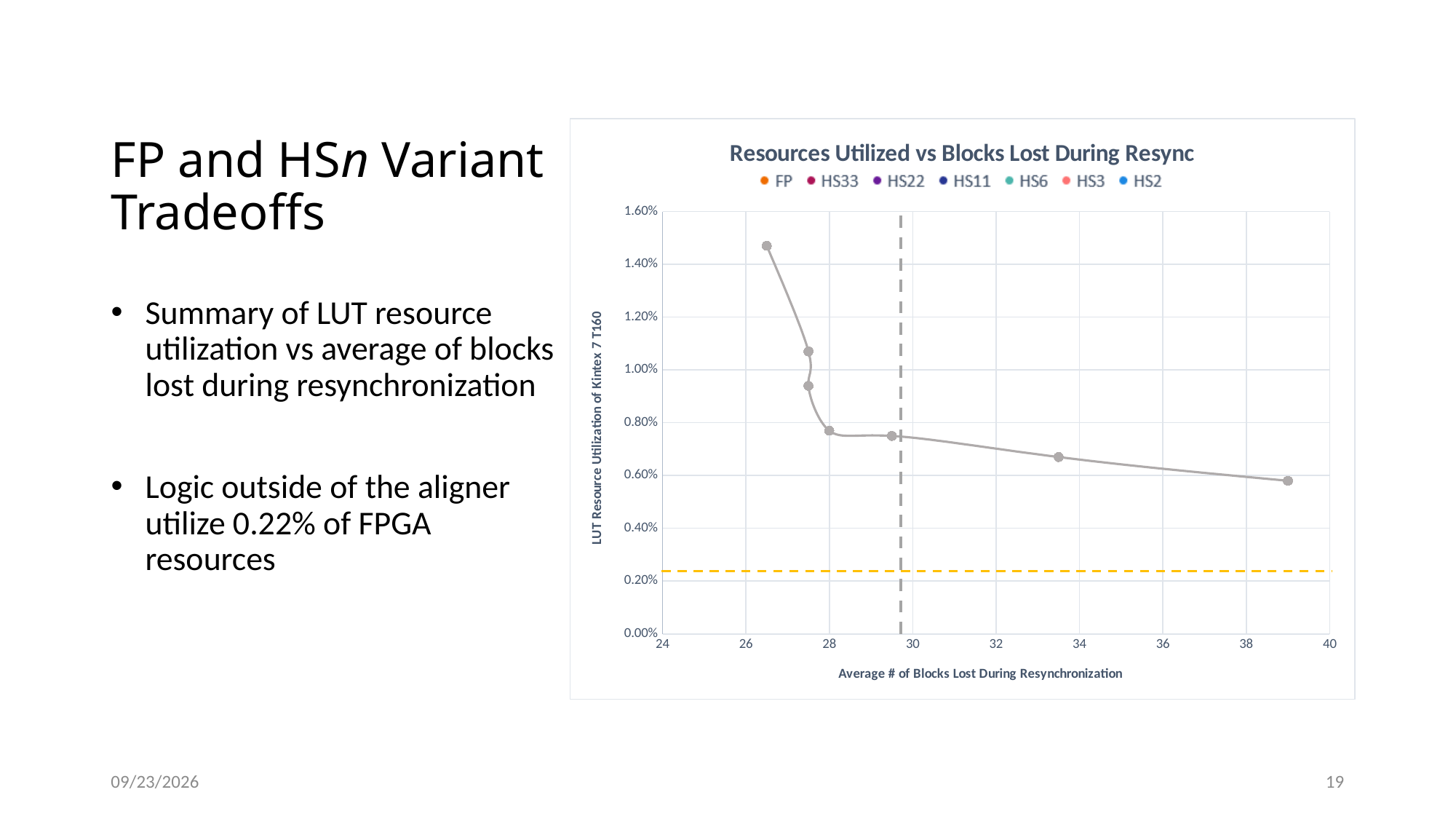
How many series does the chart legend list? 7 What is the title of the chart? Resources Utilized vs Blocks Lost During Resync What kind of chart is shown on the slide? Scatter chart with a smoothed line Is the LUT utilization of the rightmost plotted point greater or less than 0.80%? less Which plotted point has the highest LUT resource utilization? The leftmost point Which has higher LUT utilization: the leftmost plotted point or the rightmost plotted point? The leftmost point Which plotted point has the lowest LUT resource utilization? The rightmost point What is the label of the x axis? Average # of Blocks Lost During Resynchronization How many data points are plotted on the chart? 7 Is the LUT utilization of the point plotted at about 33.5 blocks lost greater or less than 0.80%? less Is the LUT utilization of the leftmost plotted point greater or less than 1.40%? greater As the average number of blocks lost increases along the x axis, does LUT resource utilization rise or fall? Fall